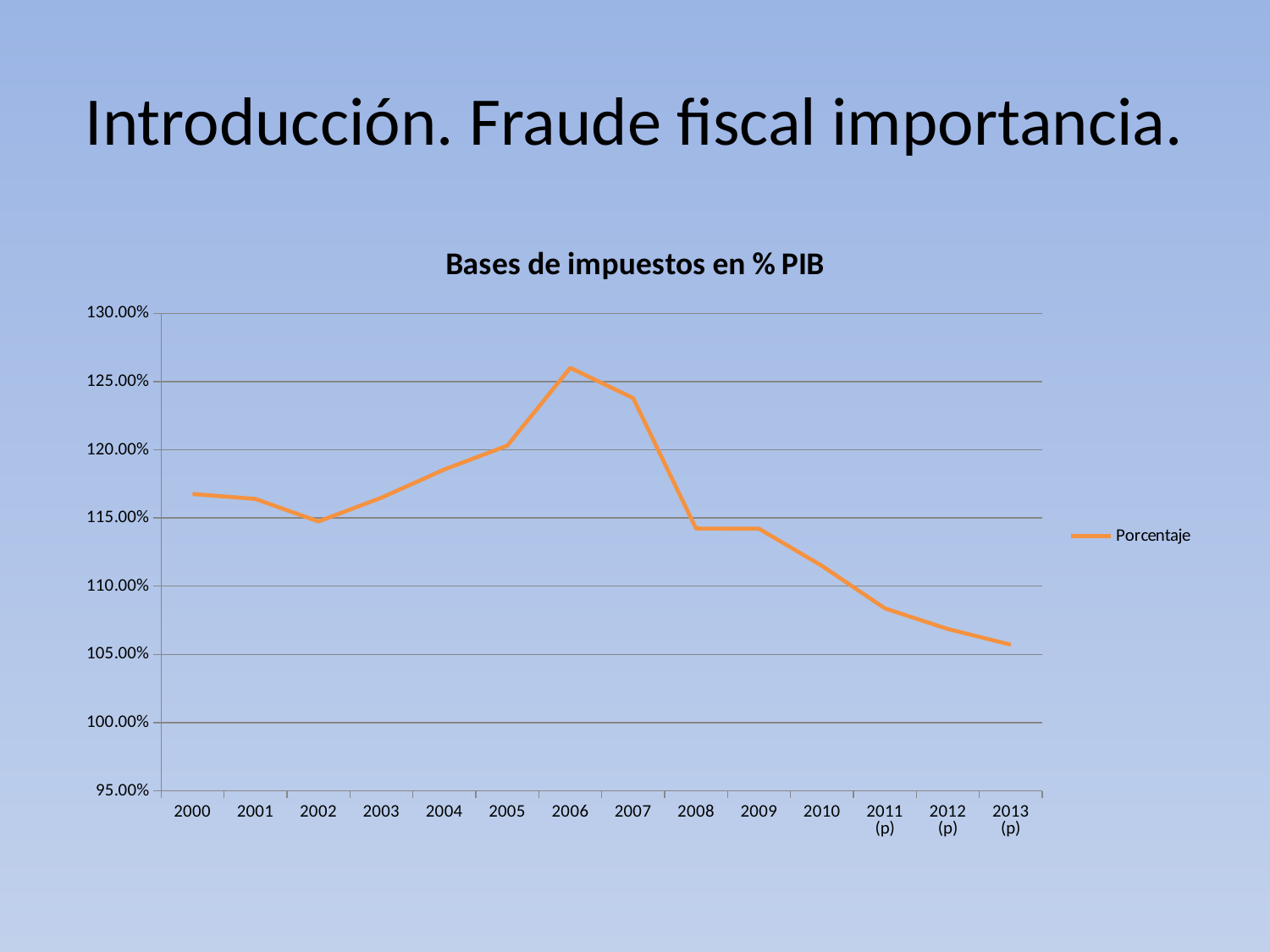
In which year does the Porcentaje line reach its lowest value? 2013 (p) How many series does the legend list? 1 What kind of chart is shown on the slide? line chart Is the value for 2008 greater or less than 115.00%? less How many years are plotted along the x axis? 14 Is the value for 2006 greater or less than 125.00%? greater What is the name of the series shown in the legend? Porcentaje Does the Porcentaje line rise or fall from 2006 to 2013 (p)? fall In which year does the Porcentaje line reach its highest value? 2006 What is the title of the chart? Bases de impuestos en % PIB Which year has the larger value, 2006 or 2010? 2006 Is the value for 2011 (p) greater or less than 110.00%? less